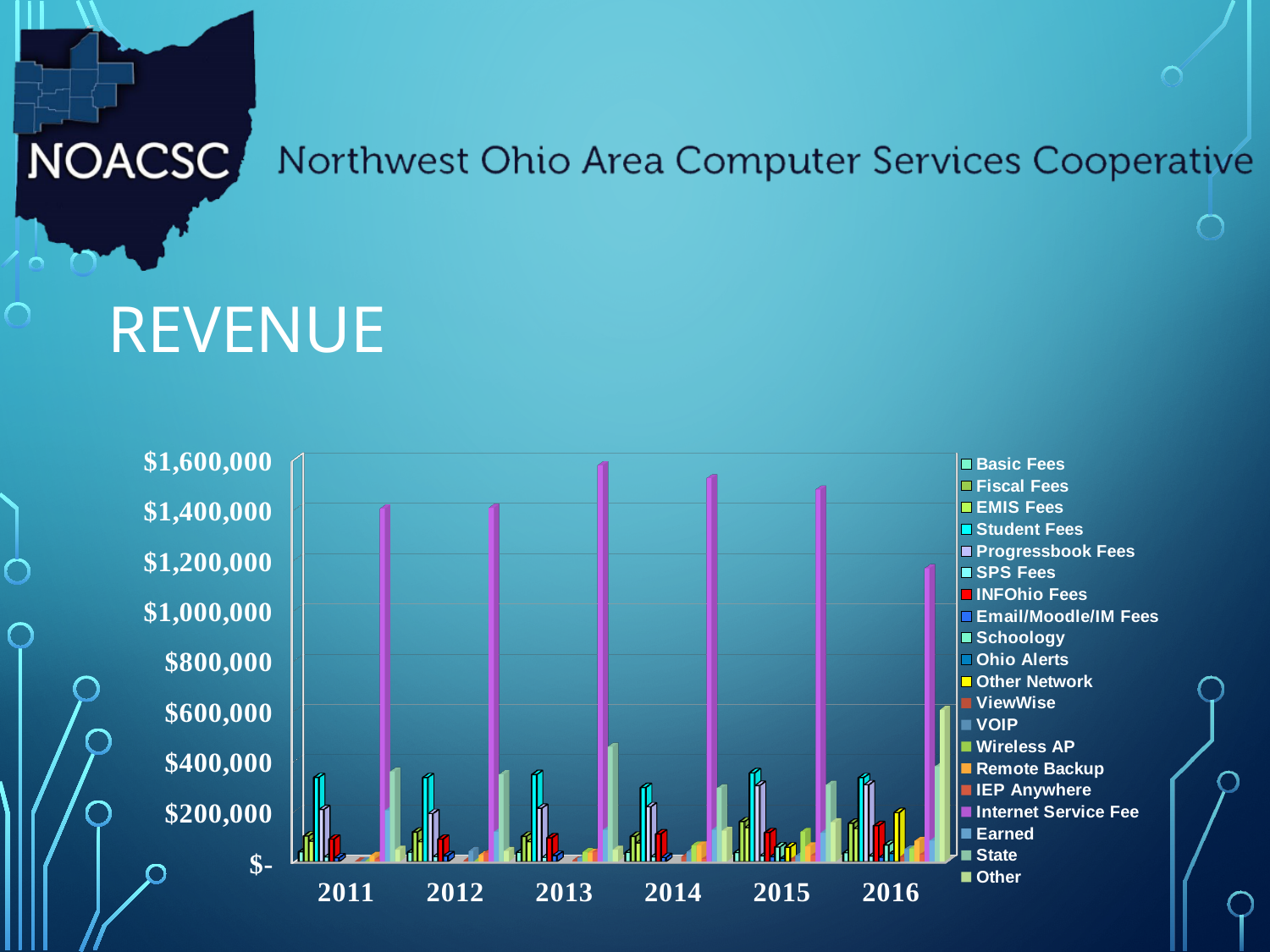
Which year has the lowest Internet Service Fee bar? 2016 How many years are shown along the x axis of the chart? 6 Is the Internet Service Fee value for 2013 greater or less than $1,400,000? greater What is the first entry listed in the chart's legend? Basic Fees Which year has the highest Internet Service Fee bar? 2013 Is the Student Fees value for 2011 greater or less than $200,000? greater What is the highest value labelled on the chart's vertical axis? $1,600,000 Does the Internet Service Fee rise or fall from 2015 to 2016? Fall Is the Internet Service Fee value for 2014 greater or less than $1,400,000? greater Which is larger, the Internet Service Fee for 2013 or for 2016? 2013 How many series does the chart's legend list? 20 What kind of chart is shown on the slide? Bar chart